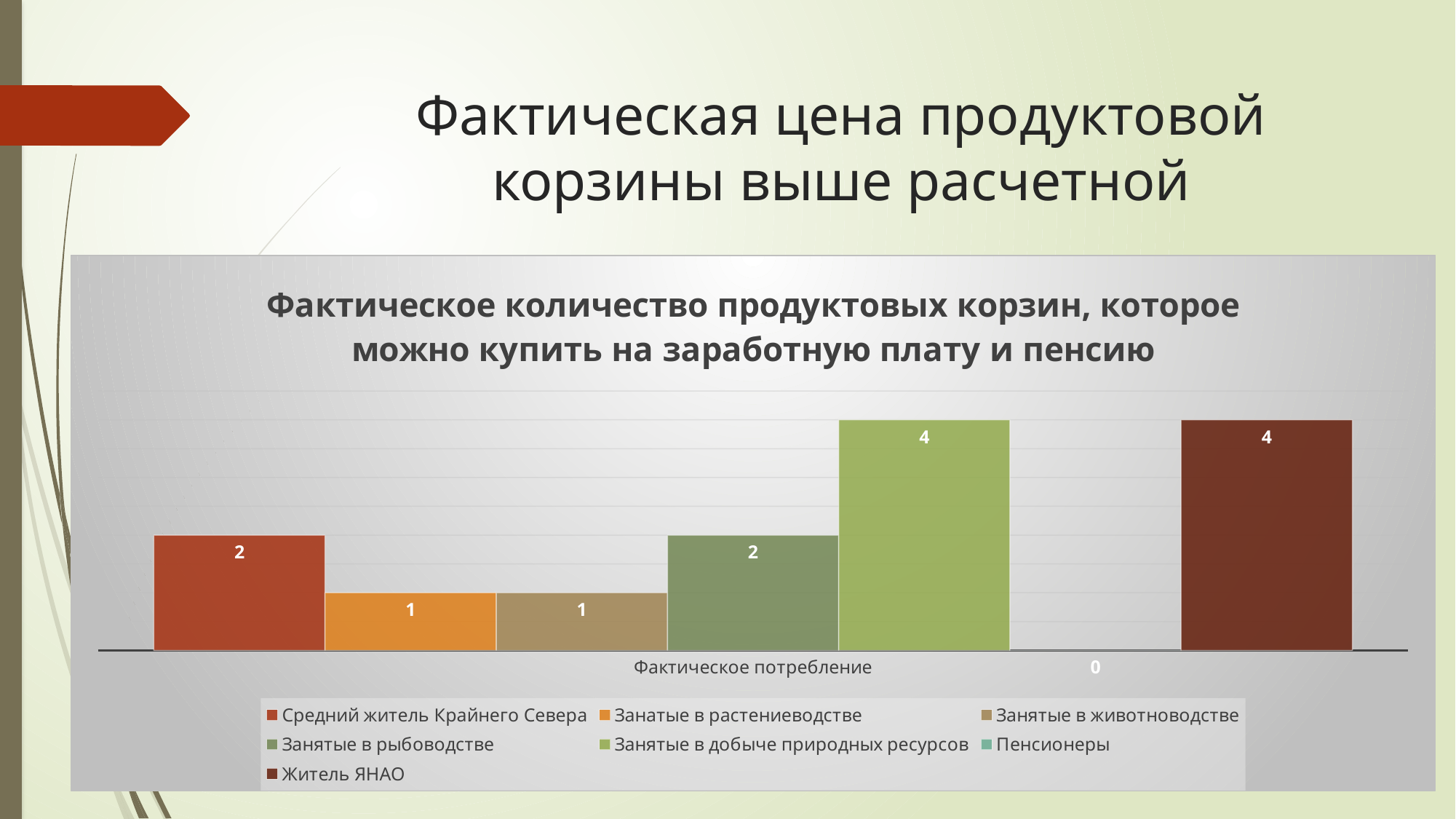
What is the value for Пенсионеры? 0 What is the title of the chart? Фактическое количество продуктовых корзин, которое можно купить на заработную плату и пенсию What is the value for Житель ЯНАО? 4 What is the value for Занятые в рыбоводстве? 2 How many series does the legend list? 7 What is the difference between the value for Занятые в добыче природных ресурсов and the value for Занатые в растениеводстве? 3 What is the value for Средний житель Крайнего Севера? 2 What type of chart is shown on the slide? bar chart Which series has the lowest value? Пенсионеры What is the difference between the value for Средний житель Крайнего Севера and the value for Занятые в животноводстве? 1 Which is larger: the value for Житель ЯНАО or the value for Занятые в рыбоводстве? Житель ЯНАО What is the value for Занятые в добыче природных ресурсов? 4